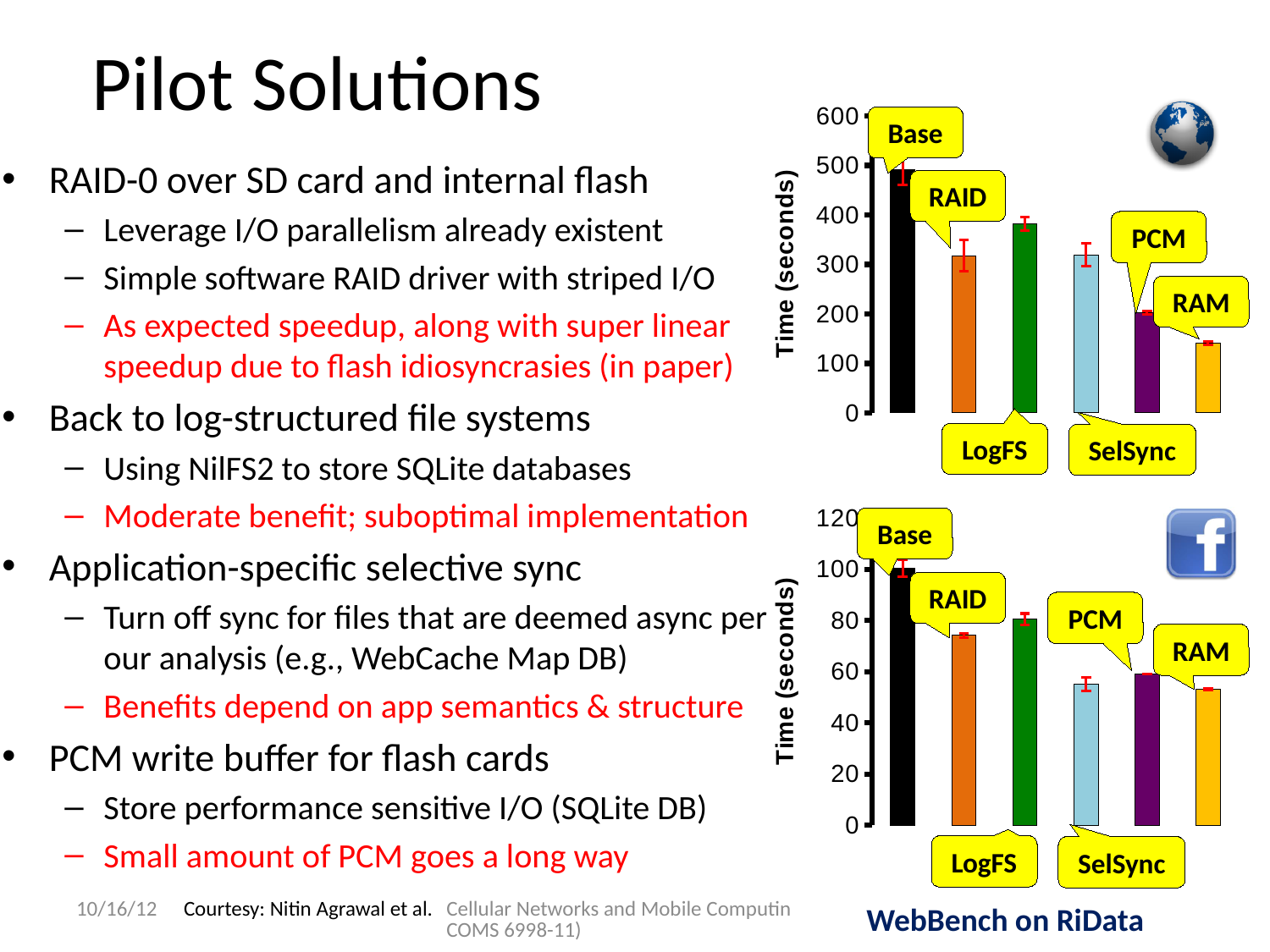
In the bottom chart, which is larger, the value for Base or the value for LogFS? Base In the bottom chart, is the value for RAID greater or less than 80? less In the top chart, which category has the highest value? Base In the top chart, is the value for Base greater or less than 400? greater What is the y-axis label of the bottom chart? Time (seconds) In the top chart, is the value for RAM greater or less than 200? less In the bottom chart, which category has the highest value? Base What kind of chart is the top chart on the slide? bar chart In the top chart, which category has the lowest value? RAM How many bars are plotted in the bottom chart? 6 In the top chart, which is larger, the value for LogFS or the value for RAID? LogFS